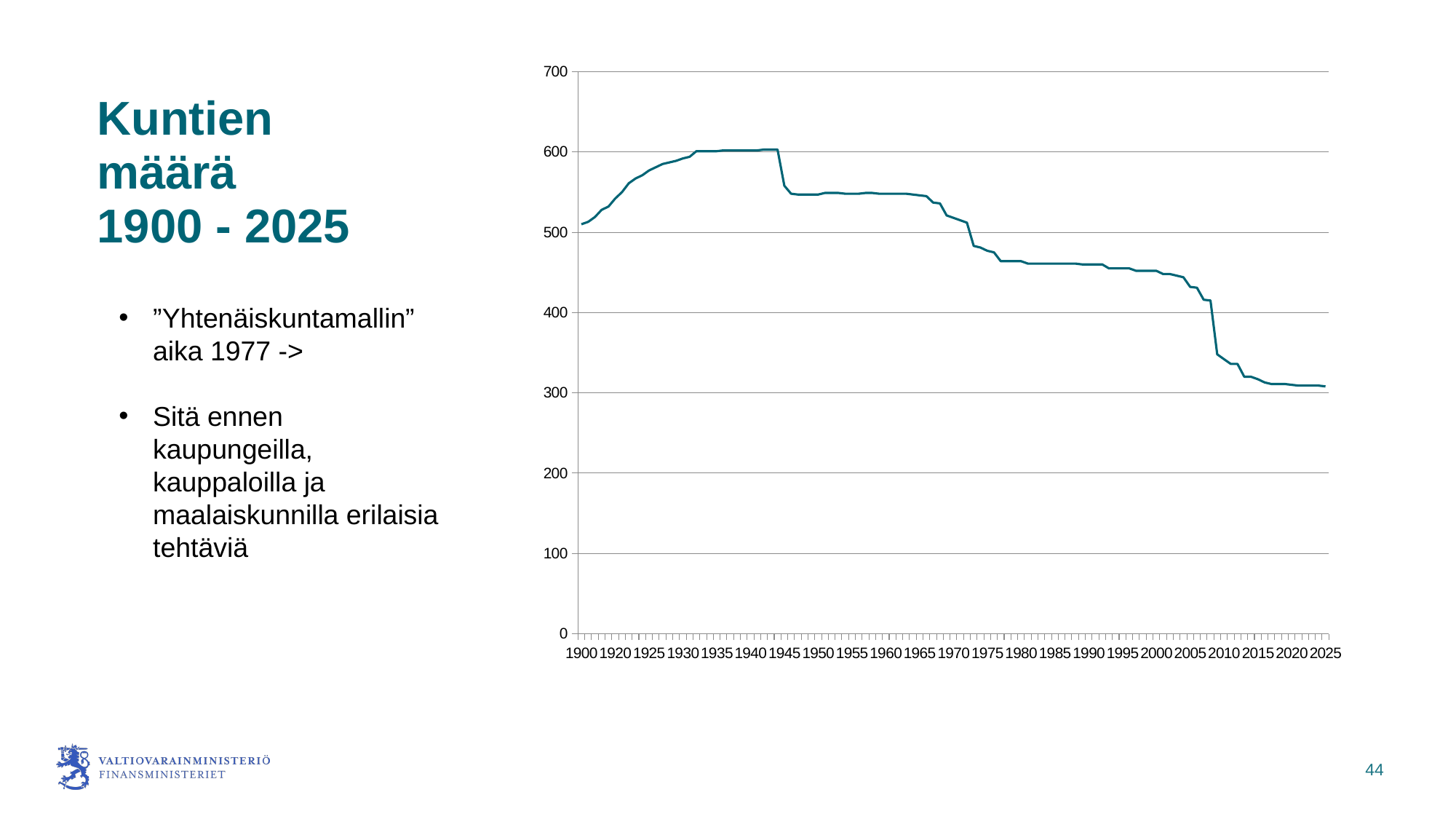
Is the value for 1900 greater or less than 500? greater Is the value for 2005 greater or less than 400? greater Is the value for 1980 greater or less than 500? less Overall, does the number of municipalities rise or fall between 1945 and 2025? fall Which year has the larger value, 1950 or 1980? 1950 What is the title of the slide containing the chart? Kuntien määrä 1900 - 2025 Does the line rise or fall between 1900 and 1930? rise Which year has the larger value, 1900 or 2025? 1900 What kind of chart is shown on the slide? line chart What is the highest value shown on the vertical axis? 700